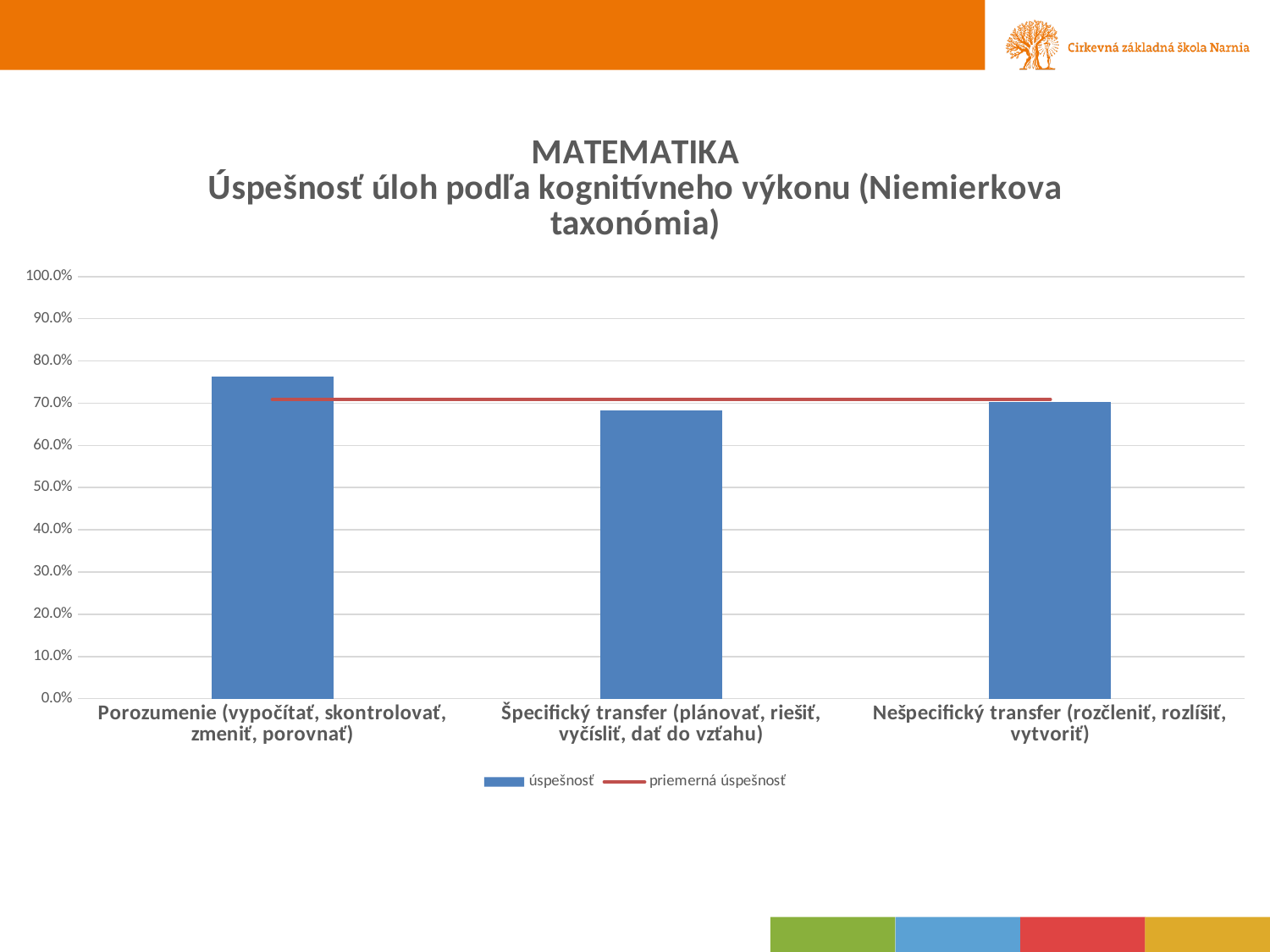
Which category has the highest úspešnosť value? Porozumenie (vypočítať, skontrolovať, zmeniť, porovnať) Is the úspešnosť value for Nešpecifický transfer (rozčleniť, rozlíšiť, vytvoriť) greater or less than 80.0%? less What does the red line in the chart represent according to the legend? priemerná úspešnosť What kind of chart is shown on the slide? bar chart What subject is named in the first line of the chart title? MATEMATIKA Is the úspešnosť value for Porozumenie (vypočítať, skontrolovať, zmeniť, porovnať) greater or less than 70.0%? greater Is the úspešnosť value for Porozumenie (vypočítať, skontrolovať, zmeniť, porovnať) greater or less than 80.0%? less How many series does the chart legend list? 2 Which has a larger úspešnosť value: Porozumenie (vypočítať, skontrolovať, zmeniť, porovnať) or Nešpecifický transfer (rozčleniť, rozlíšiť, vytvoriť)? Porozumenie (vypočítať, skontrolovať, zmeniť, porovnať) Which has a larger úspešnosť value: Porozumenie (vypočítať, skontrolovať, zmeniť, porovnať) or Špecifický transfer (plánovať, riešiť, vyčísliť, dať do vzťahu)? Porozumenie (vypočítať, skontrolovať, zmeniť, porovnať) How many categories are shown on the x axis of the chart? 3